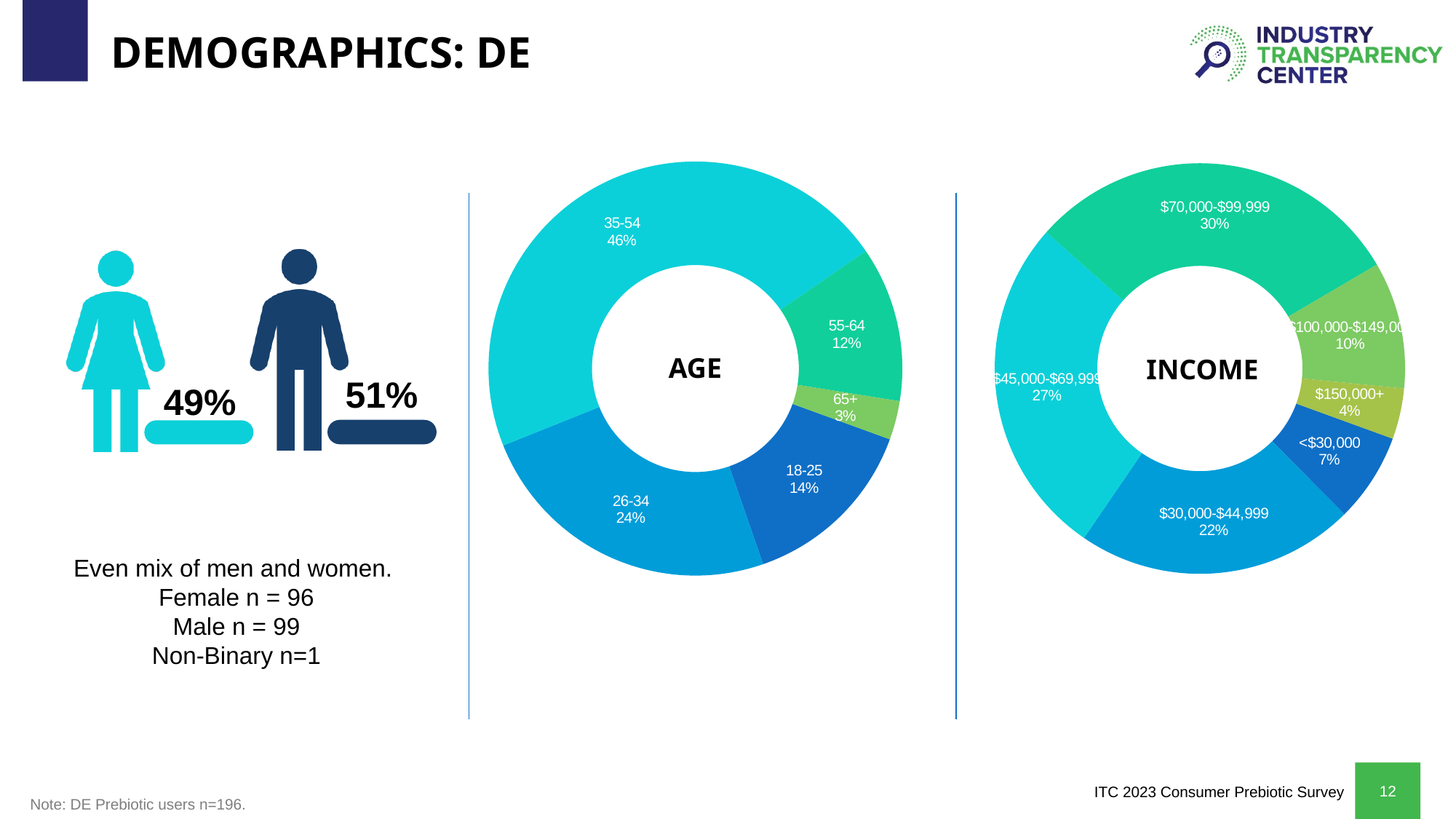
In the INCOME chart, what share of respondents earn less than $30,000? 7% In the AGE chart, which age group has the smallest share? 65+ In the INCOME chart, which income bracket has the smallest share? $150,000+ In the AGE chart, how many age groups are shown? 5 In the INCOME chart, which is larger: the share for $45,000-$69,999 or the share for $30,000-$44,999? $45,000-$69,999 In the INCOME chart, what share of respondents earn $70,000-$99,999? 30% In the AGE chart, what share of respondents are aged 18-25? 14% In the AGE chart, what share of respondents are aged 35-54? 46% In the AGE chart, which age group has the largest share? 35-54 In the AGE chart, what is the difference in percentage points between the 35-54 and 26-34 groups? 22 What kind of chart is the AGE chart? Doughnut chart In the INCOME chart, how many income brackets are shown? 6